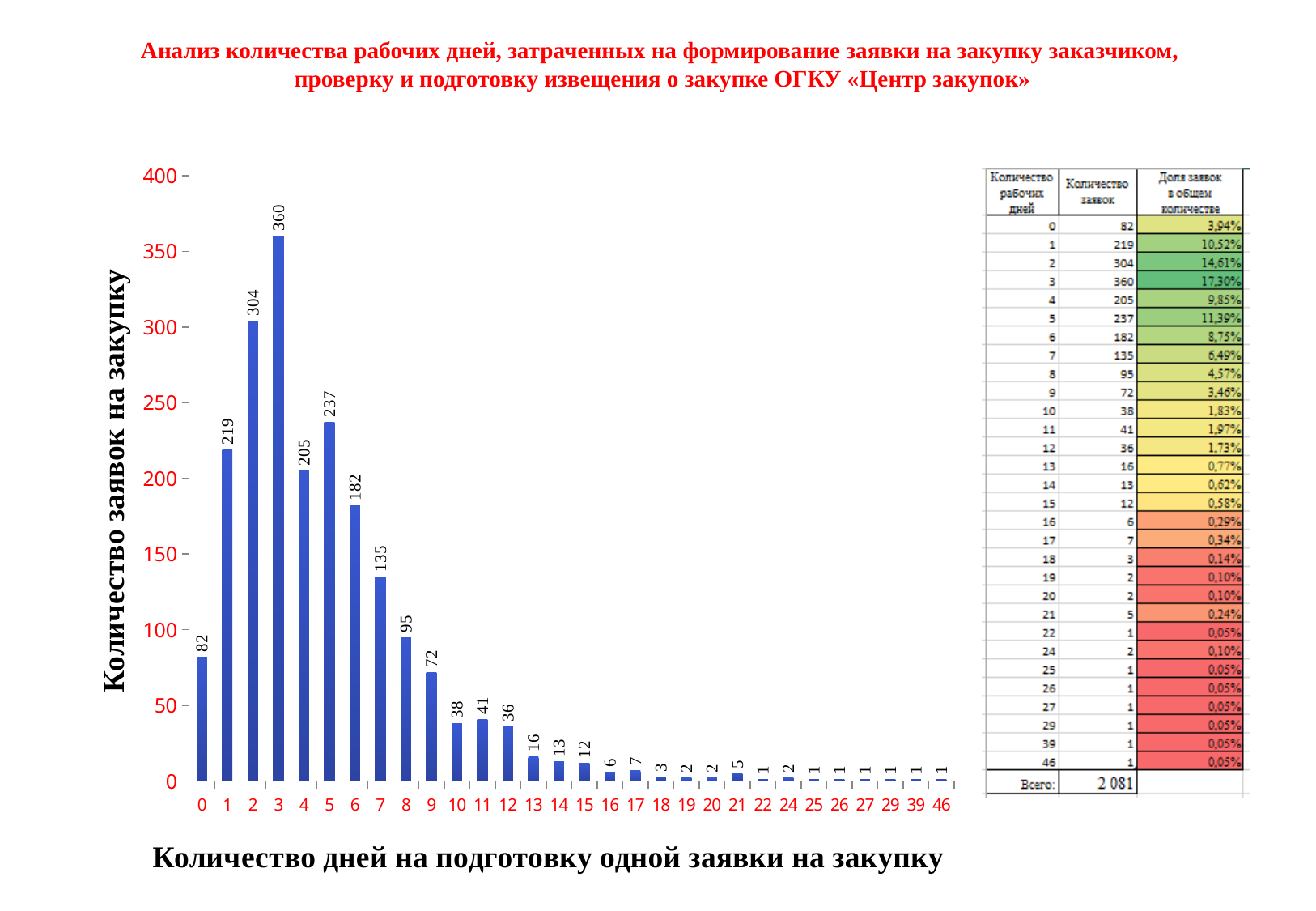
What is the difference between the values for 2 days and 1 day? 85 How many categories are shown on the x axis of the chart? 30 How many purchase requests took 3 working days to prepare? 360 What is the value for the category 46 days? 1 Which number of days has the highest number of requests? 3 What is the value for the category 0 days? 82 What is the label of the y axis of the chart? Количество заявок на закупку What type of chart is shown on the slide? bar chart What is the value for the category 7 days? 135 Which is larger, the value for 4 days or the value for 5 days? 5 days Is the value for 6 days greater or less than 150? greater